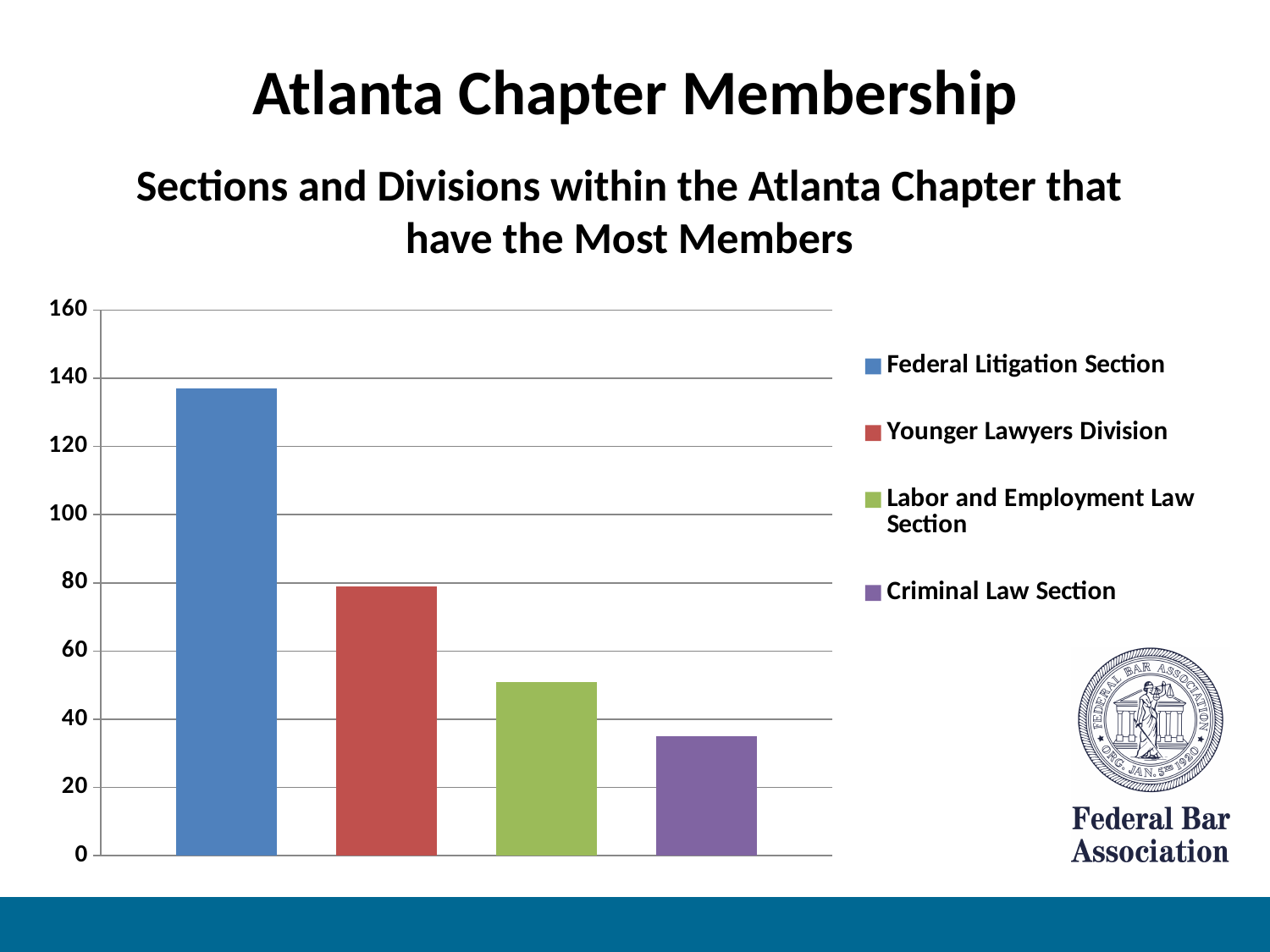
Is the value for Federal Litigation Section greater or less than 120? greater Which has more members, Younger Lawyers Division or Labor and Employment Law Section? Younger Lawyers Division Which section or division has the highest membership in the chart? Federal Litigation Section Is the value for Criminal Law Section greater or less than 40? less What is the title of the chart? Sections and Divisions within the Atlanta Chapter that have the Most Members How many bars are plotted in the chart? 4 What colour is the bar for Criminal Law Section? purple Is the value for Labor and Employment Law Section greater or less than 40? greater How many entries does the chart's legend list? 4 What kind of chart is shown on the slide? bar chart Which section or division has the lowest membership in the chart? Criminal Law Section